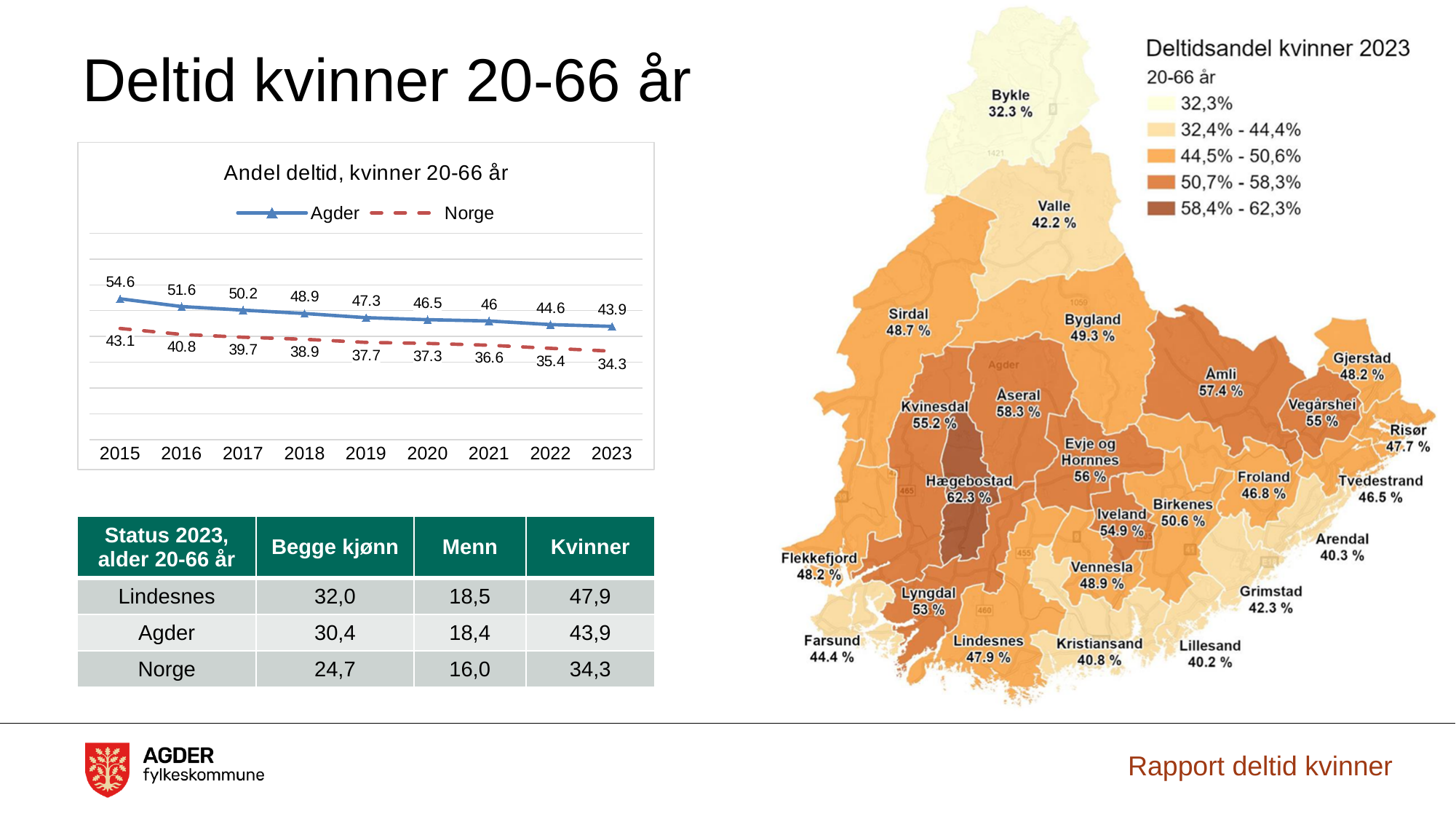
How many series does the legend of the chart 'Andel deltid, kvinner 20-66 år' list? 2 How many years are shown on the x axis of the chart 'Andel deltid, kvinner 20-66 år'? 9 In the chart 'Andel deltid, kvinner 20-66 år', what is the value for Norge in 2017? 39.7 In the chart 'Andel deltid, kvinner 20-66 år', which year has the highest value for Agder? 2015 In the chart 'Andel deltid, kvinner 20-66 år', what is the difference between the Agder values in 2015 and 2023? 10.7 In the chart 'Andel deltid, kvinner 20-66 år', what is the difference between the Agder and Norge values in 2023? 9.6 In the chart 'Andel deltid, kvinner 20-66 år', which is larger in 2020: the Agder value or the Norge value? Agder In the chart 'Andel deltid, kvinner 20-66 år', what is the value for Agder in 2015? 54.6 In the chart 'Andel deltid, kvinner 20-66 år', what is the value for Norge in 2023? 34.3 In the chart 'Andel deltid, kvinner 20-66 år', do the Agder values rise or fall from 2015 to 2023? fall In the chart 'Andel deltid, kvinner 20-66 år', what is the value for Agder in 2019? 47.3 In the chart 'Andel deltid, kvinner 20-66 år', which year has the lowest value for Norge? 2023